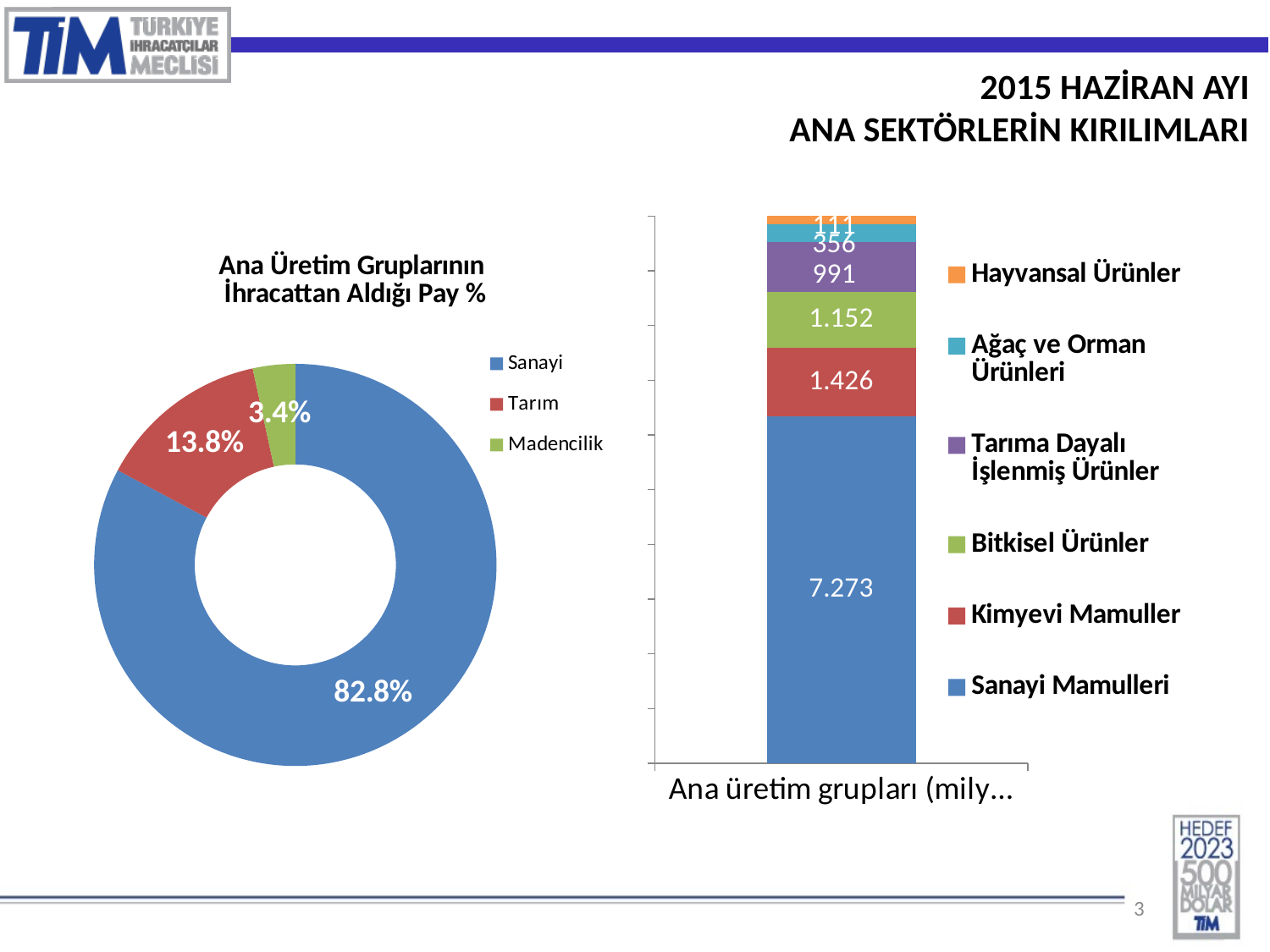
In the stacked bar chart on the right, how many series does the legend list? 6 In the doughnut chart 'Ana Üretim Gruplarının İhracattan Aldığı Pay %', what share does Tarım have? 13.8% In the stacked bar chart on the right, what is the value for Kimyevi Mamuller? 1.426 In the stacked bar chart on the right, which series has the largest value? Sanayi Mamulleri In the doughnut chart 'Ana Üretim Gruplarının İhracattan Aldığı Pay %', how many categories does the legend list? 3 In the doughnut chart 'Ana Üretim Gruplarının İhracattan Aldığı Pay %', what share does Sanayi have? 82.8% In the doughnut chart 'Ana Üretim Gruplarının İhracattan Aldığı Pay %', what is the difference between the Tarım and Madencilik shares? 10.4% In the stacked bar chart on the right, what is the value for Bitkisel Ürünler? 1.152 In the stacked bar chart on the right, what is the value for Tarıma Dayalı İşlenmiş Ürünler? 991 In the doughnut chart 'Ana Üretim Gruplarının İhracattan Aldığı Pay %', which category has the smallest share? Madencilik In the stacked bar chart on the right, what is the value for Sanayi Mamulleri? 7.273 What kind of chart is the chart on the right of the slide? Stacked bar chart